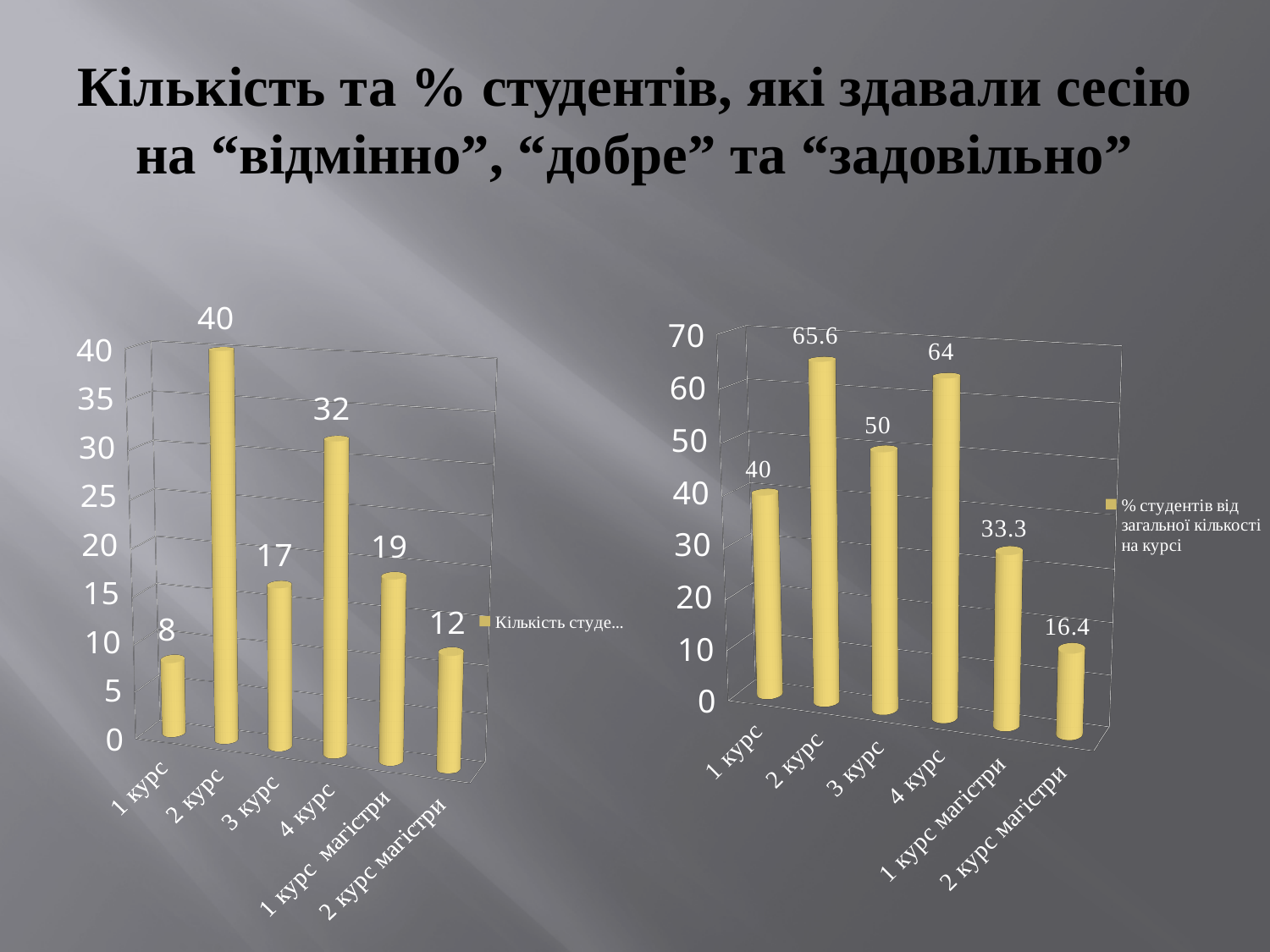
In the right chart, which category has the highest value? 2 курс What is the legend entry of the right chart? % студентів від загальної кількості на курсі In the left chart, what is the value for 1 курс магістри? 19 In the right chart, what is the value for 4 курс? 64 How many categories are shown in the left chart? 6 What kind of chart is the right chart? bar chart In the left chart, what is the difference between the values for 2 курс and 4 курс? 8 In the right chart, what is the value for 2 курс магістри? 16.4 In the right chart, what is the difference between the values for 3 курс and 1 курс магістри? 16.7 In the left chart, which category has the lowest value? 1 курс In the left chart, what is the value for 2 курс? 40 In the right chart, which is larger, the value for 1 курс or the value for 3 курс? 3 курс